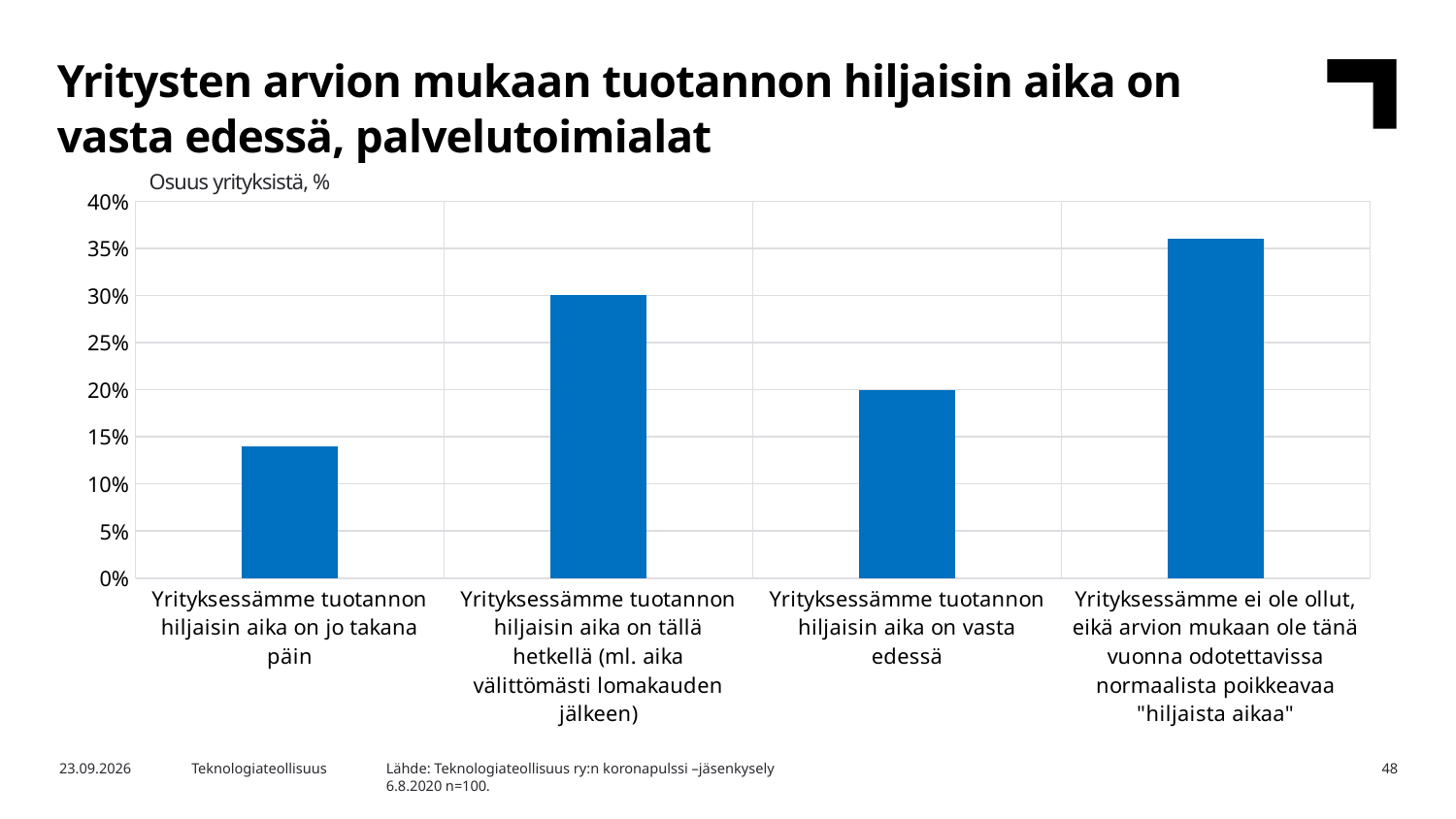
What is the label of the vertical axis shown above the chart? Osuus yrityksistä, % What is the value for "Yrityksessämme tuotannon hiljaisin aika on tällä hetkellä (ml. aika välittömästi lomakauden jälkeen)"? 30% Which category has the lowest value? Yrityksessämme tuotannon hiljaisin aika on jo takana päin What is the maximum value shown on the vertical axis? 40% Which is larger: the value for "Yrityksessämme tuotannon hiljaisin aika on tällä hetkellä" or the value for "Yrityksessämme tuotannon hiljaisin aika on vasta edessä"? Yrityksessämme tuotannon hiljaisin aika on tällä hetkellä Is the value for "Yrityksessämme ei ole ollut, eikä arvion mukaan ole tänä vuonna odotettavissa normaalista poikkeavaa 'hiljaista aikaa'" greater or less than 35%? greater What is the difference between the values for "Yrityksessämme tuotannon hiljaisin aika on tällä hetkellä" and "Yrityksessämme tuotannon hiljaisin aika on vasta edessä"? 10% Is the value for "Yrityksessämme tuotannon hiljaisin aika on jo takana päin" greater or less than 15%? less How many categories (bars) does the chart show? 4 What kind of chart is shown on the slide? bar chart Which category has the highest value? Yrityksessämme ei ole ollut, eikä arvion mukaan ole tänä vuonna odotettavissa normaalista poikkeavaa "hiljaista aikaa" What is the value for "Yrityksessämme tuotannon hiljaisin aika on vasta edessä"? 20%